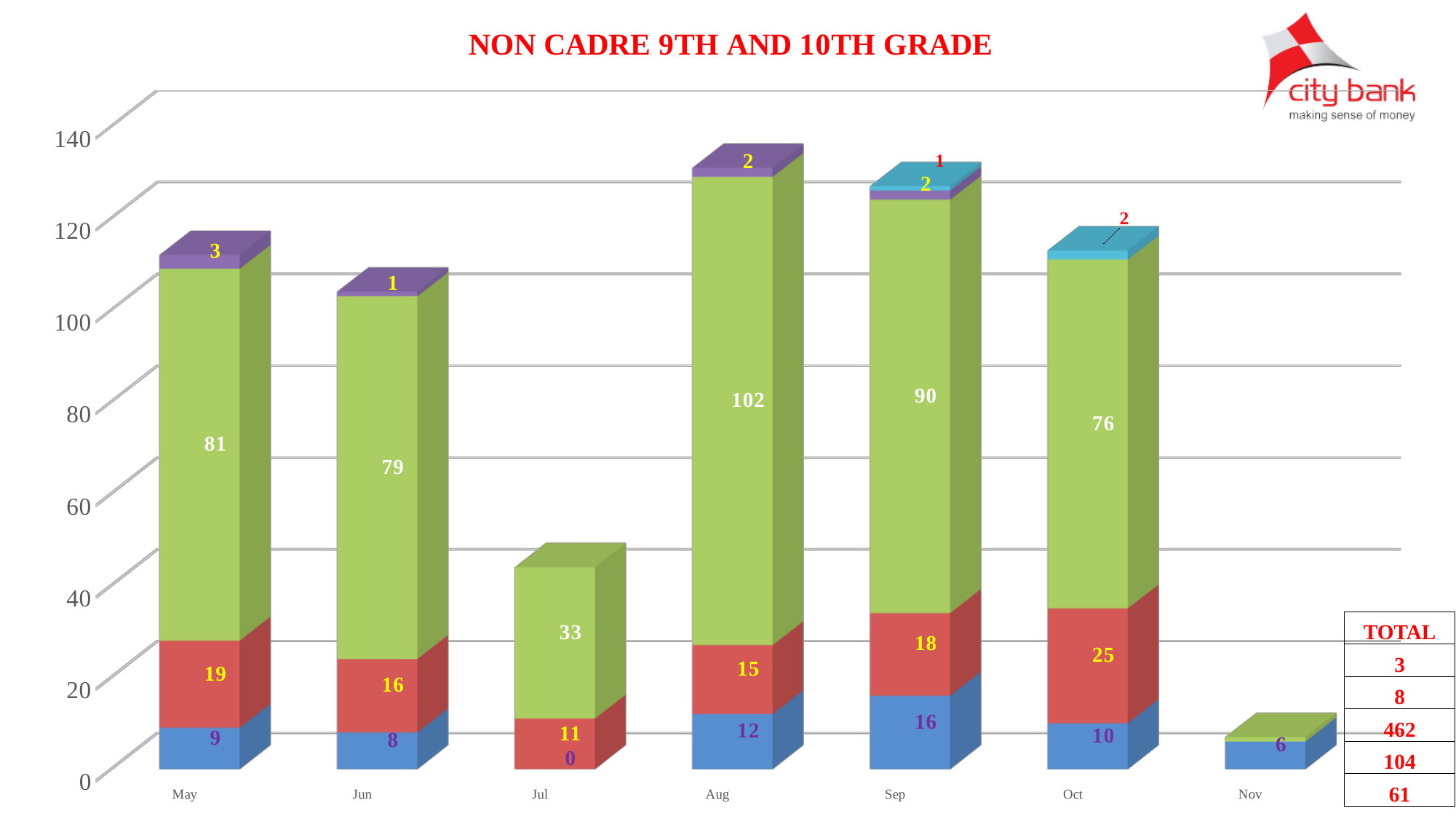
What is the difference between the green segments for Aug and Sep? 12 How many months are shown on the x axis? 7 What is the value of the red segment for Oct? 25 Is the red segment larger for May or for Jun? May What is the value of the green segment for Aug? 102 What is the value of the blue segment for Sep? 16 Which month has the largest green segment? Aug What is the title of the chart? NON CADRE 9TH AND 10TH GRADE What is the value of the purple segment for May? 3 What is the total of the stacked bar for May? 112 What is the total of the stacked bar for Jul? 44